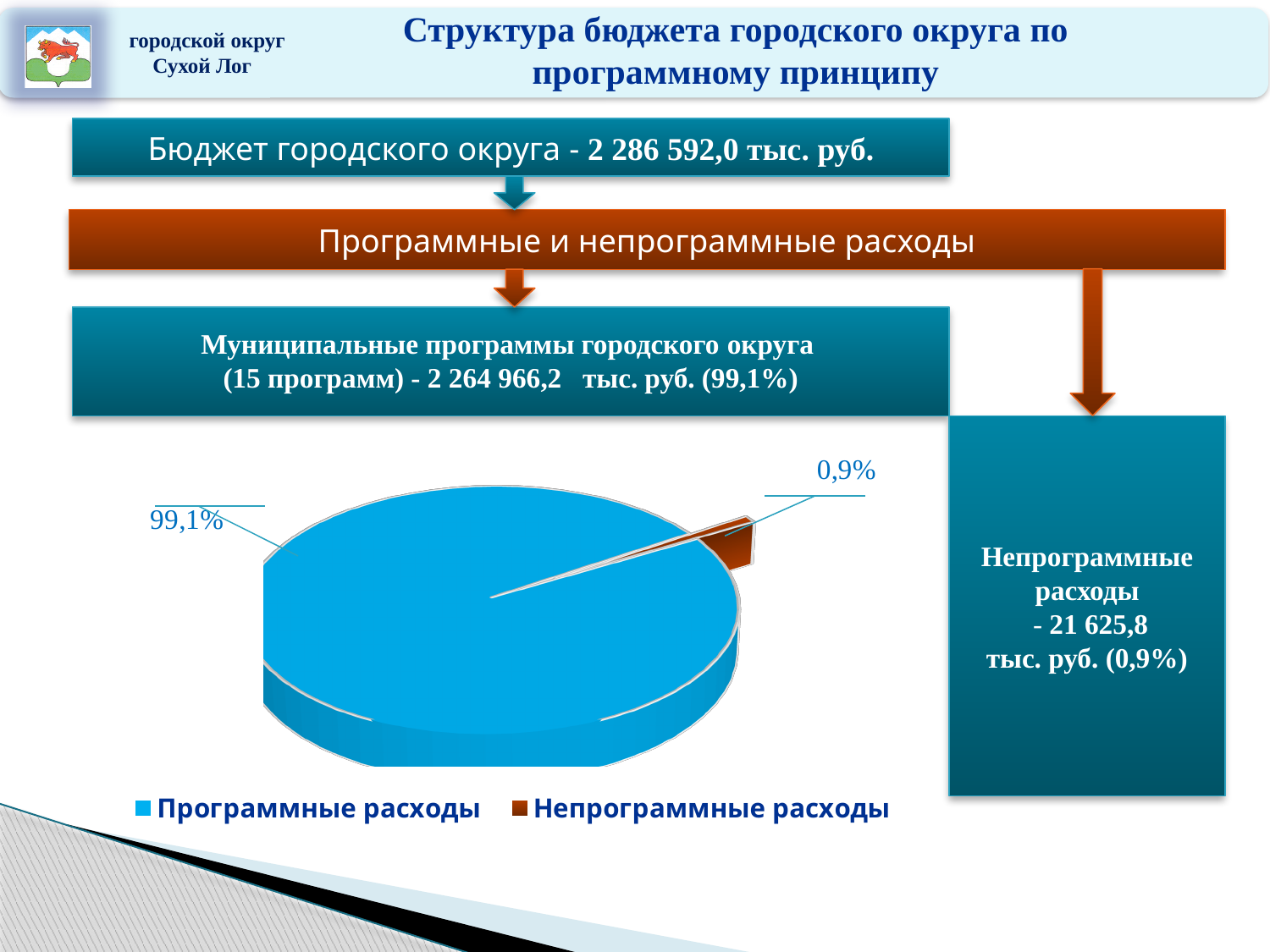
Which is larger, the share for Программные расходы or for Непрограммные расходы? Программные расходы Which slice of the pie is the largest? Программные расходы What colour is the Непрограммные расходы slice in the pie chart? brown What share of the pie does Непрограммные расходы have? 0,9% How many entries does the legend list? 2 What colour is the Программные расходы slice in the pie chart? blue Which slice of the pie is the smallest? Непрограммные расходы What is the difference in percentage points between Программные расходы and Непрограммные расходы? 98,2 What share of the pie does Программные расходы have? 99,1% How many slices does the pie chart have? 2 What kind of chart is shown on the slide? pie chart